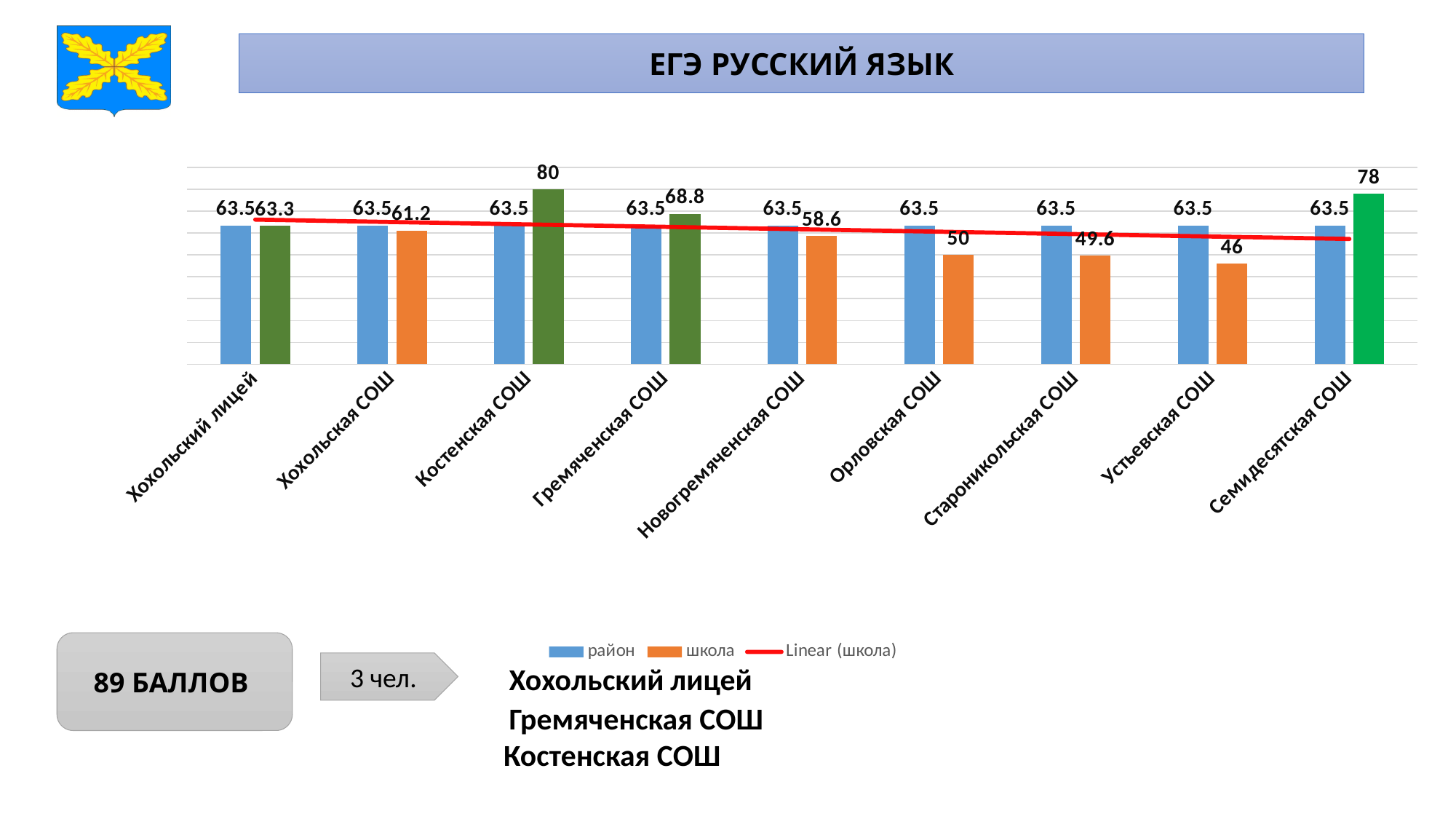
How many entries does the chart legend list? 3 Which school has the highest школа value? Костенская СОШ What is the школа value for Семидесятская СОШ? 78 What is the difference between the школа values for Костенская СОШ and Семидесятская СОШ? 2 What kind of chart is shown on the slide? bar chart What is the район value for Орловская СОШ? 63.5 What is the title shown above the chart? ЕГЭ РУССКИЙ ЯЗЫК What is the школа value for Устьевская СОШ? 46 What is the школа value for Костенская СОШ? 80 Which is larger for Гремяченская СОШ: the район value or the школа value? школа Which school has the lowest школа value? Устьевская СОШ How many schools are shown on the x axis of the chart? 9